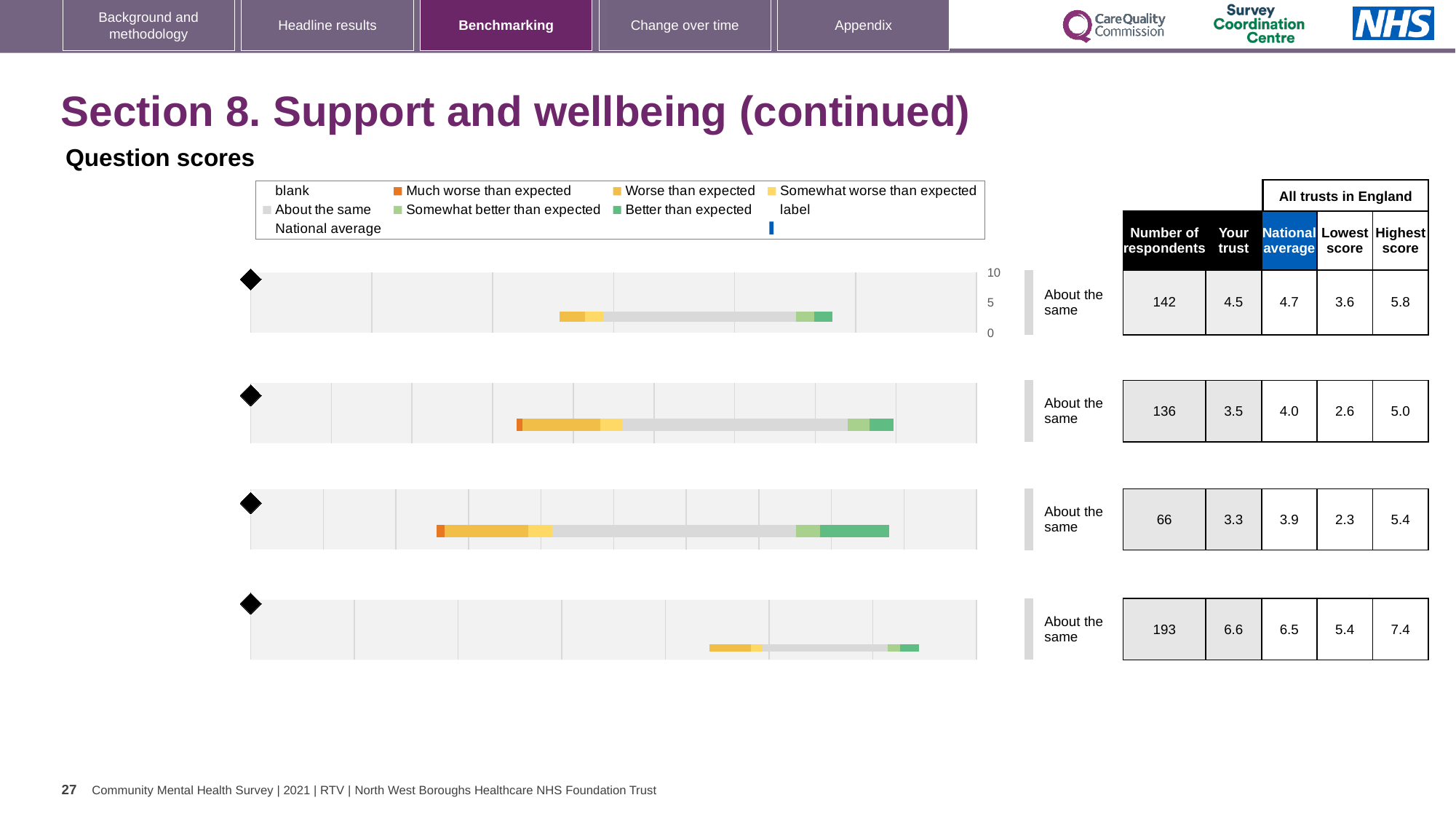
Which chart row has the highest 'Your trust' score? the fourth (bottom) row, 6.6 What benchmark category label is shown next to each of the four chart rows? About the same Which chart row has the lowest number of respondents? the third row, 66 For the first (top) chart row, what is the number of respondents shown in the table? 142 What kind of chart is used to show the question scores on this slide? bar chart For the second chart row, what is the lowest score among all trusts in England? 2.6 For the fourth (bottom) chart row, what is the highest score among all trusts in England? 7.4 For the fourth (bottom) chart row, what is the difference between the highest score and the lowest score? 2.0 For the third chart row, what is the national average score? 3.9 How many question score charts (rows) are shown on the slide? 4 For the second chart row, what is the 'Your trust' score? 3.5 For the first (top) chart row, which is larger: the 'Your trust' score or the national average? national average